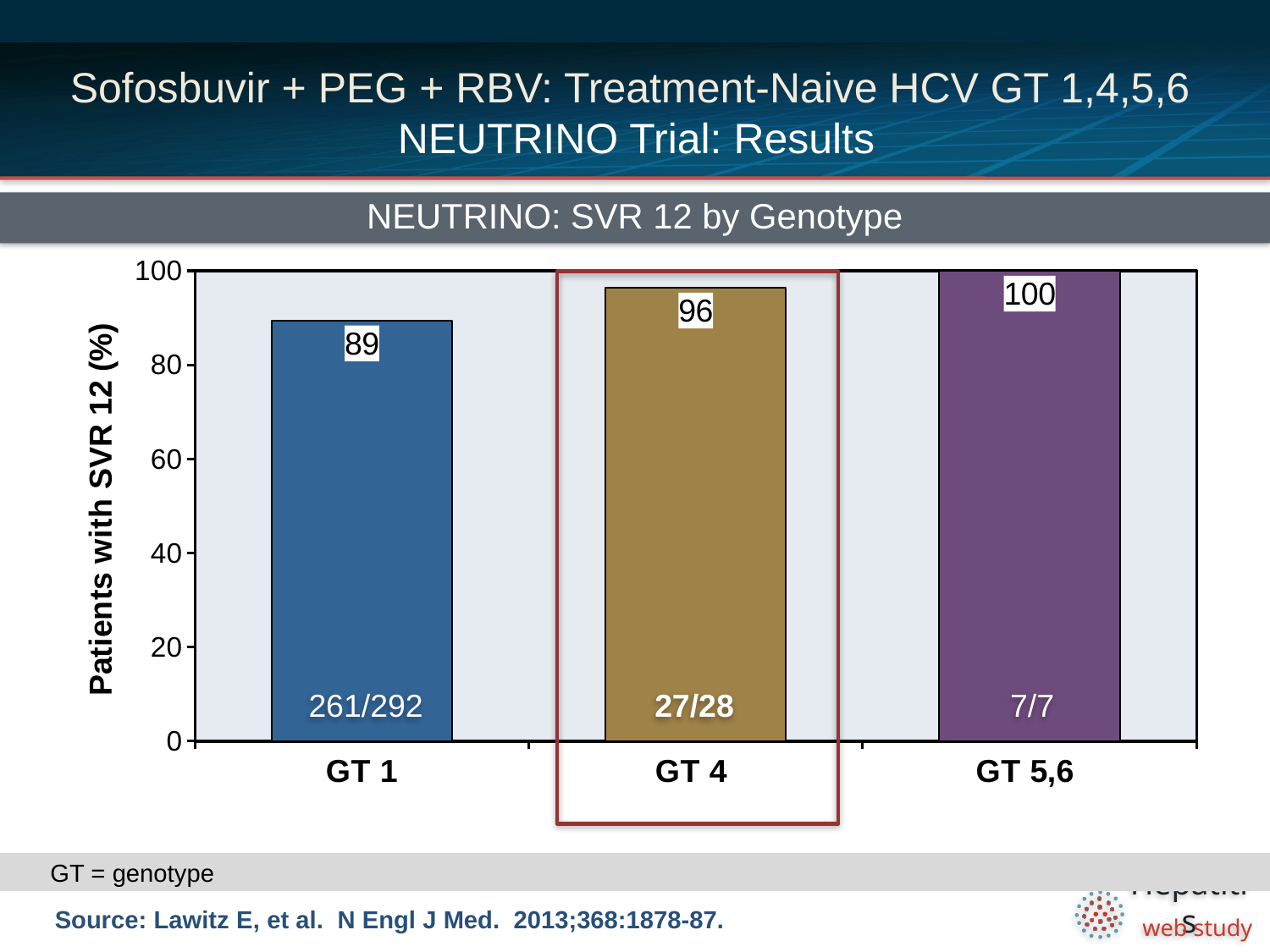
Which has a higher SVR 12 rate, GT 1 or GT 4? GT 4 How many genotype groups are shown on the x axis? 3 What is the difference in SVR 12 rate between GT 4 and GT 1? 7 What is the SVR 12 rate for GT 4? 96 Do the SVR 12 rates rise or fall from GT 1 to GT 5,6? Rise What is the title of the chart? NEUTRINO: SVR 12 by Genotype How many patients achieved SVR 12 in the GT 4 group, as shown on the bar? 27/28 Which genotype group has the highest SVR 12 rate? GT 5,6 What is the SVR 12 rate for GT 5,6? 100 Which genotype group has the lowest SVR 12 rate? GT 1 What kind of chart is shown? Bar chart What is the SVR 12 rate for GT 1? 89